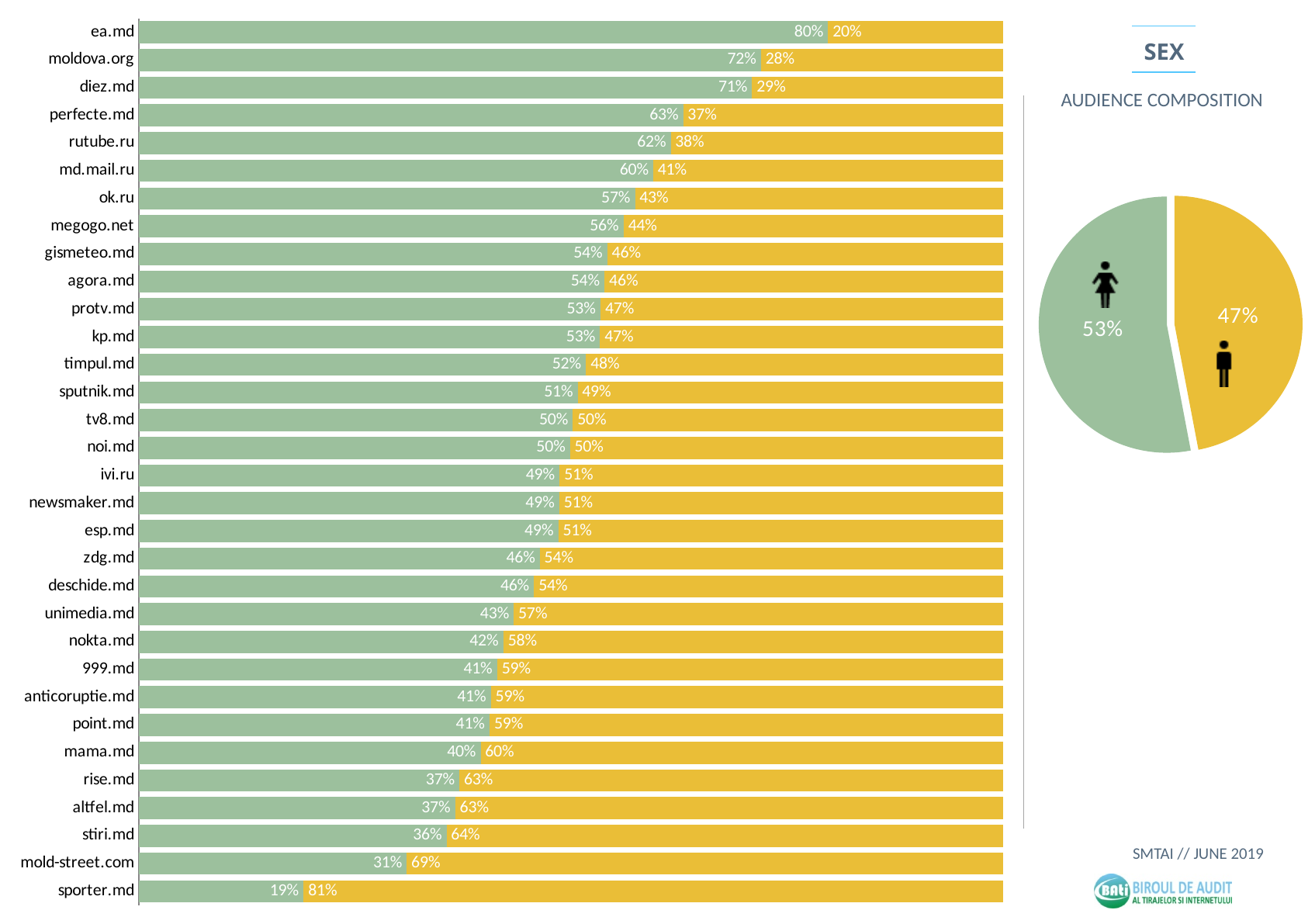
What kind of chart is the chart on the left of the slide? stacked bar chart In the bar chart, what is the green segment value for mold-street.com? 31% How many sites are listed in the bar chart? 32 In the bar chart, which site has the highest green segment value? ea.md In the bar chart, what is the yellow segment value for sporter.md? 81% In the pie chart, what share of the audience is female? 53% In the bar chart, what is the green segment value for ea.md? 80% In the bar chart, what is the difference between the green and yellow segment values for moldova.org? 44 percentage points In the bar chart, which site has the lowest green segment value? sporter.md In the pie chart, what share of the audience is male? 47% In the bar chart, which is larger for stiri.md: the green segment or the yellow segment? the yellow segment What is the title shown above the pie chart? SEX